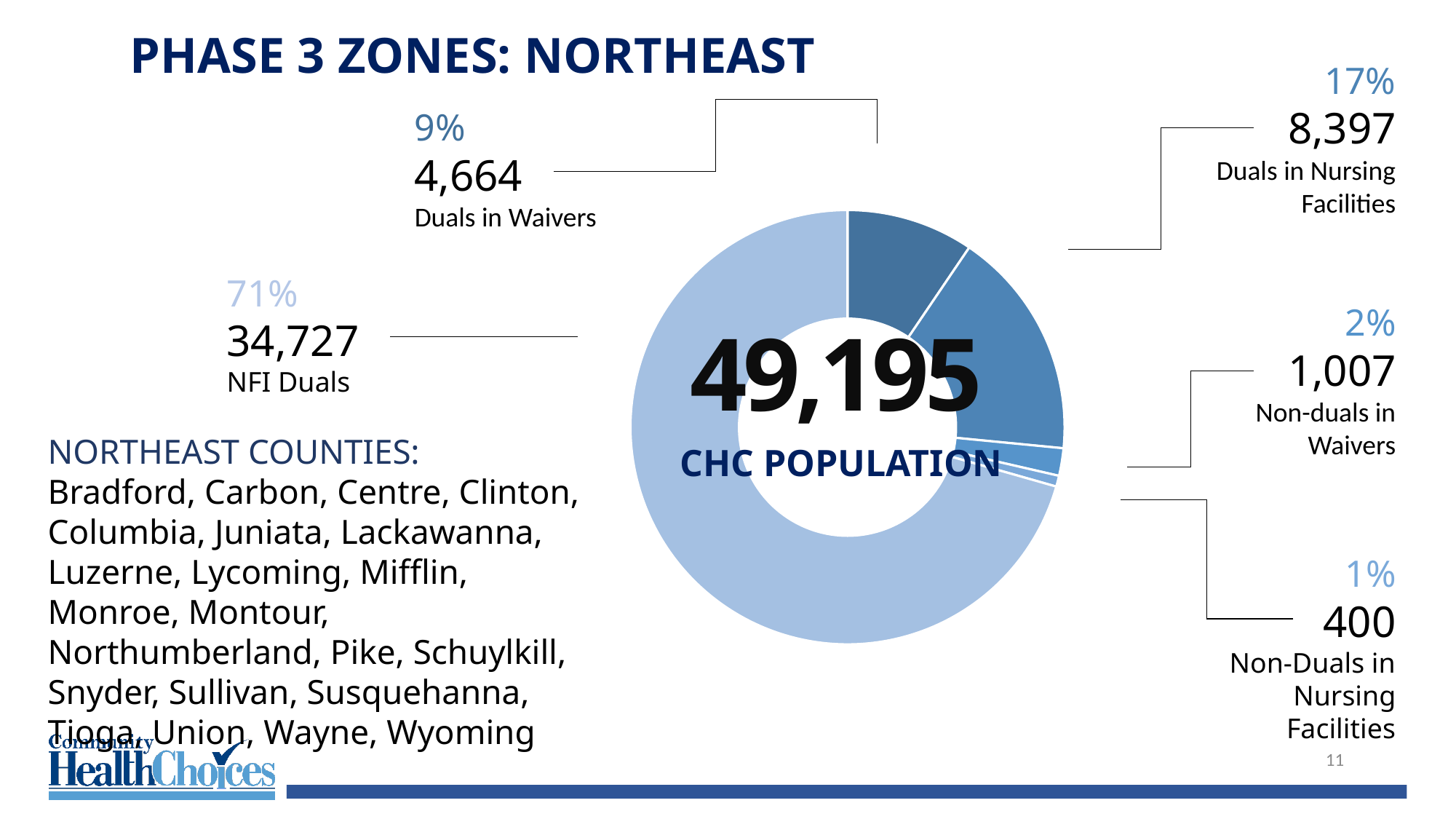
What share of the CHC population is NFI Duals? 71% What is the difference between the number of Duals in Nursing Facilities and the number of Duals in Waivers? 3,733 How many categories does the donut chart divide the CHC population into? 5 Which category has the smallest share of the CHC population? Non-Duals in Nursing Facilities Which is larger: Non-duals in Waivers or Non-Duals in Nursing Facilities? Non-duals in Waivers What value is shown for Duals in Nursing Facilities? 8,397 What kind of chart is used to show the CHC population breakdown? Donut (pie) chart What is the total CHC population shown in the centre of the donut chart? 49,195 Which category has the largest share of the CHC population? NFI Duals What is the title of the slide containing the chart? PHASE 3 ZONES: NORTHEAST How many NFI Duals are shown on the chart? 34,727 What percentage of the CHC population is Duals in Waivers? 9%